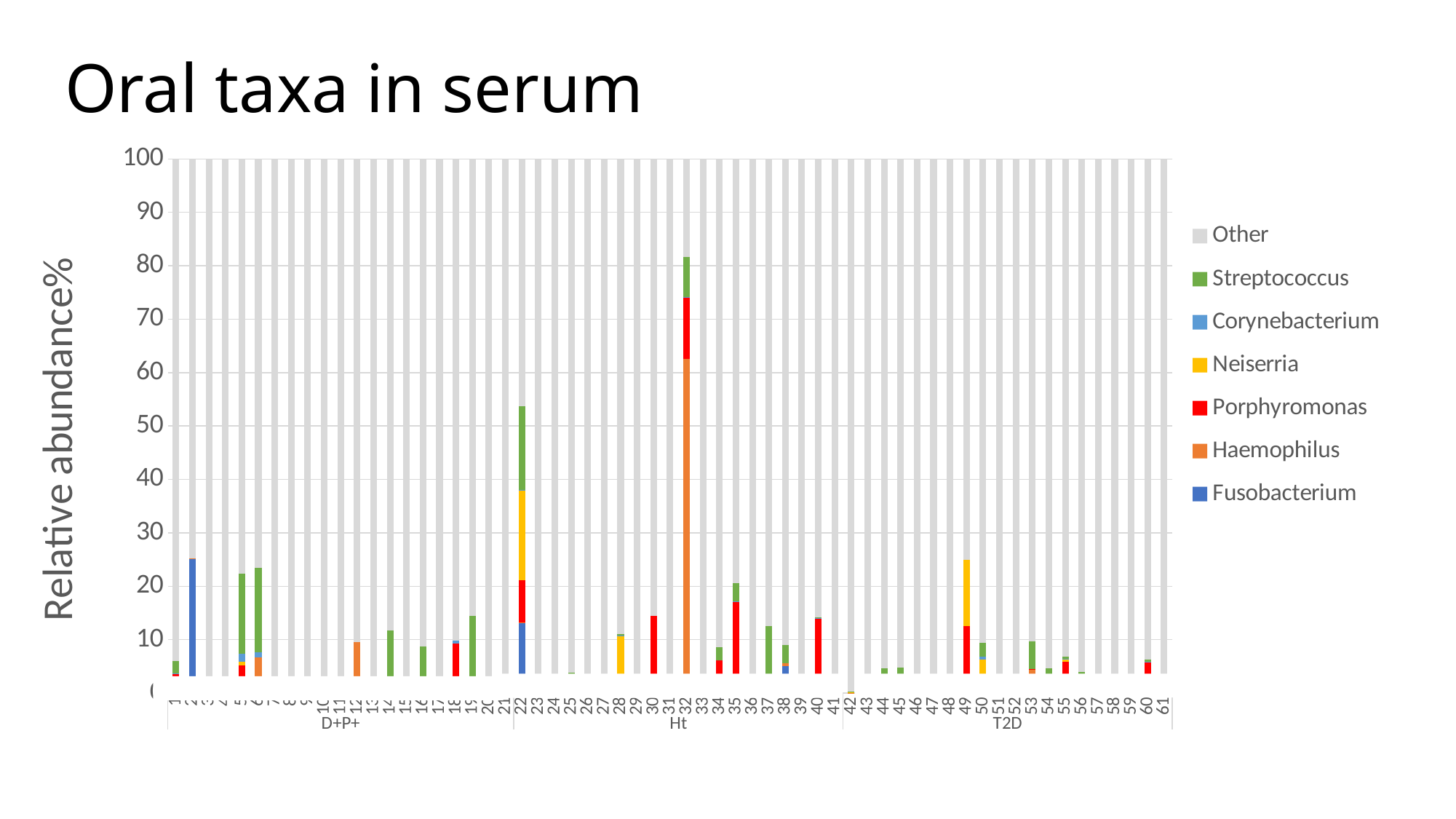
How many sample groups are labelled beneath the x axis? 3 Which sample has the larger Fusobacterium segment, sample 2 or sample 22? Sample 2 Which sample has the largest Haemophilus segment? 32 What is the total height of each stacked bar, including the Other segment? 100 Is the Fusobacterium value for sample 2 greater or less than 20? greater What is the label on the vertical axis? Relative abundance% Is the Haemophilus value for sample 32 greater or less than 50? greater How many series does the legend list? 7 How many samples (bars) are plotted along the x axis? 61 What is the title of the chart? Oral taxa in serum What kind of chart is shown on the slide? Stacked bar chart Which sample has the largest Fusobacterium segment? 2